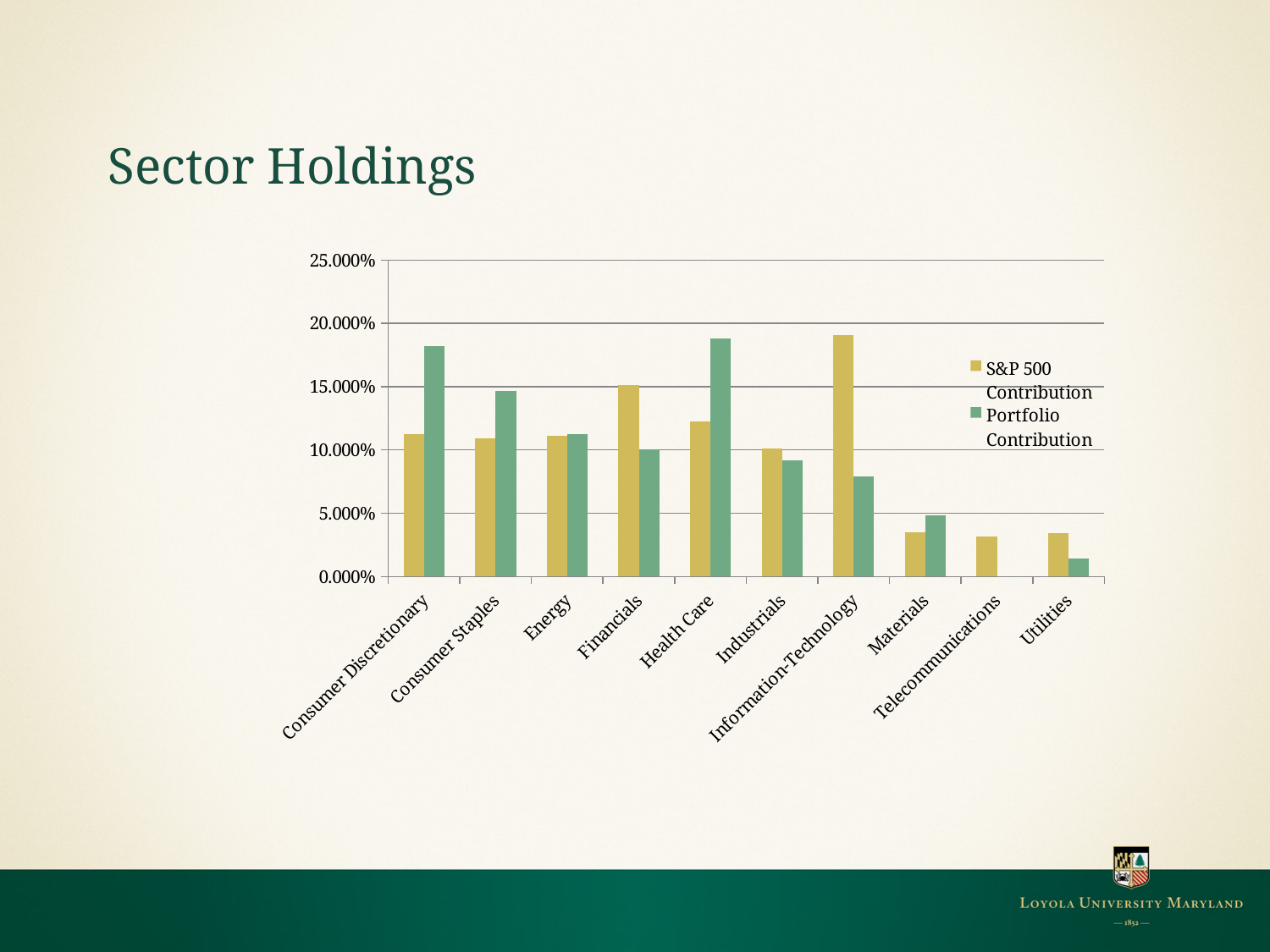
How many series does the legend list? 2 Which sector has the highest S&P 500 Contribution? Information-Technology How many sector categories are shown on the x axis? 10 What kind of chart is shown on the slide? bar chart Is the S&P 500 Contribution for Materials greater or less than 5.000%? less Is the S&P 500 Contribution for Information-Technology greater or less than 15.000%? greater Is the Portfolio Contribution for Health Care greater or less than 15.000%? greater For Information-Technology, which is larger: the S&P 500 Contribution or the Portfolio Contribution? S&P 500 Contribution Which sector has the lowest Portfolio Contribution? Telecommunications What is the title of the slide containing the chart? Sector Holdings For Consumer Discretionary, which is larger: the S&P 500 Contribution or the Portfolio Contribution? Portfolio Contribution